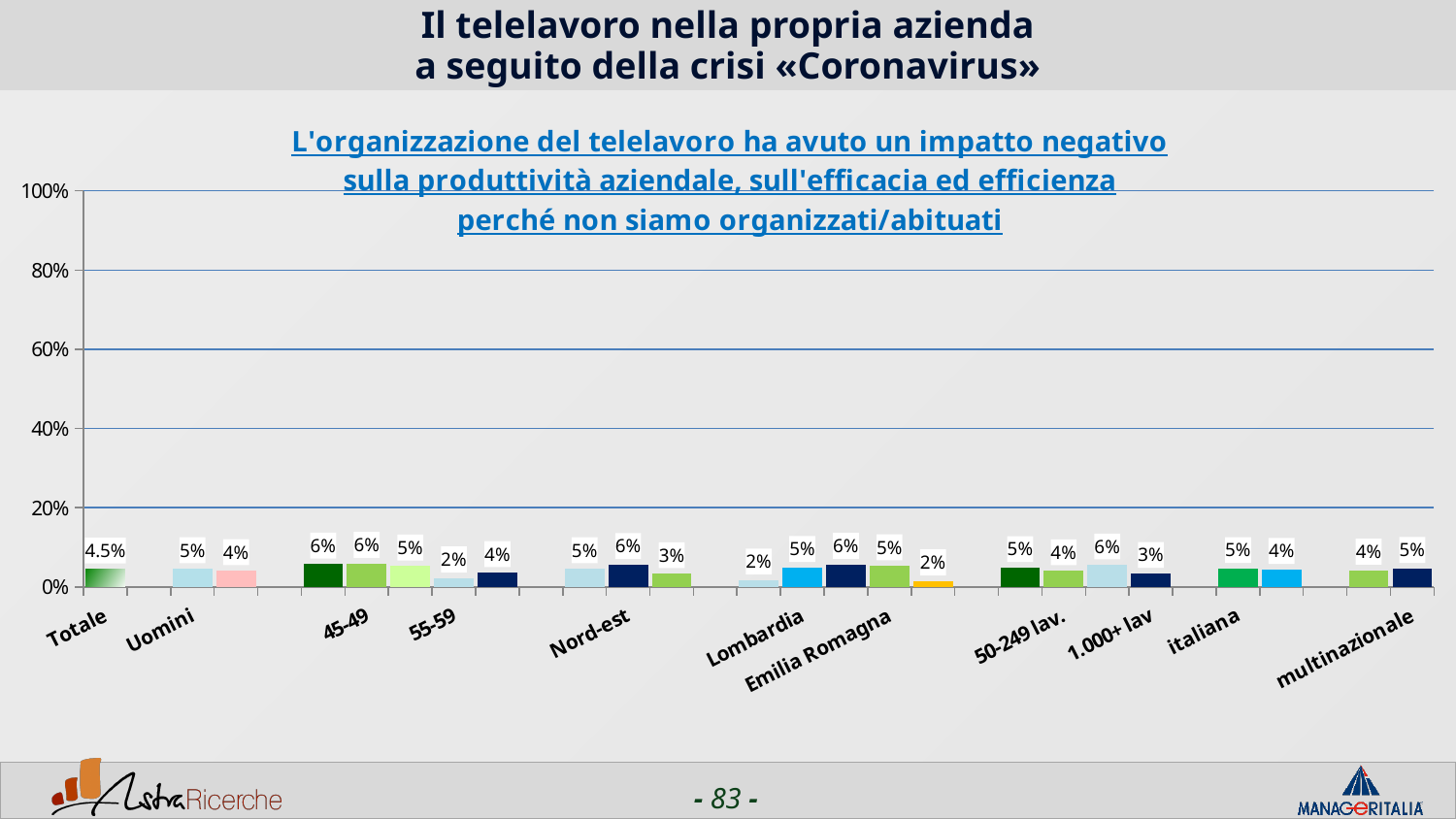
What is the highest value shown on the vertical axis? 100% Is the value for Totale greater or less than 20%? less What is the value for Totale? 4.5% What is the value for Uomini? 5% Which has the larger value, 45-49 or 55-59? 45-49 What is the value for the 55-59 age group? 2% What is the value for the 45-49 age group? 6% What is the value for 1.000+ lav? 3% What is the value for 50-249 lav.? 4% What is the value for Nord-est? 6% What type of chart is shown on the slide? bar chart What is the difference between the values for 45-49 and 55-59? 4 percentage points